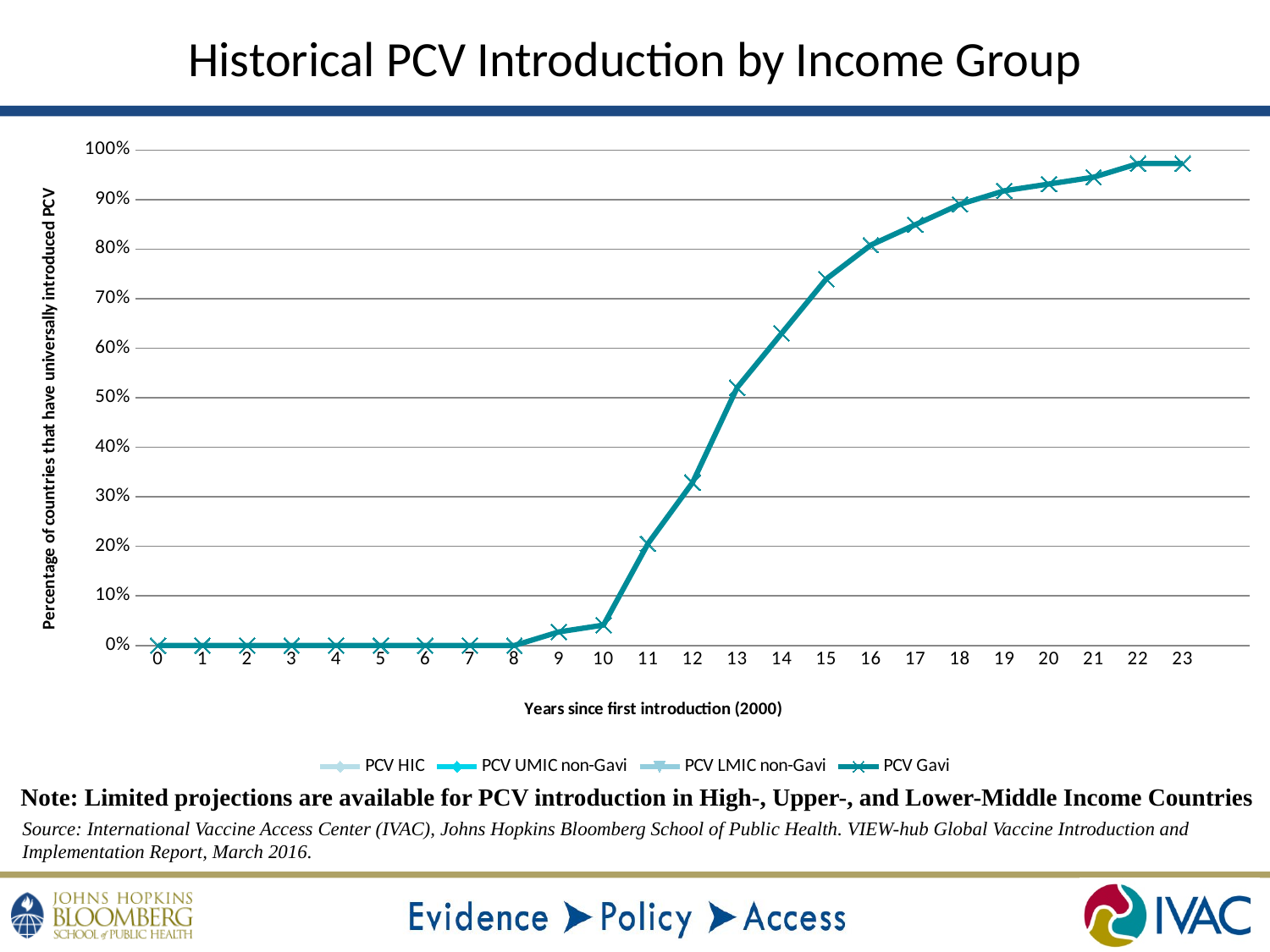
How many series does the legend list? 4 What is the title of the chart? Historical PCV Introduction by Income Group What kind of chart is shown on the slide? line chart What is the value of the PCV Gavi series at year 0? 0% What is the value of the PCV Gavi series at year 5? 0% Is the PCV Gavi value at year 14 greater or less than 60%? greater What is the label of the x axis? Years since first introduction (2000) Which is larger for the PCV Gavi series: the value at year 12 or the value at year 15? year 15 Does the PCV Gavi series rise or fall as years since first introduction increase? rise Is the PCV Gavi value at year 18 greater or less than 80%? greater How many points along the x axis (years since first introduction) are plotted for the PCV Gavi series? 24 Is the PCV Gavi value at year 11 greater or less than 30%? less